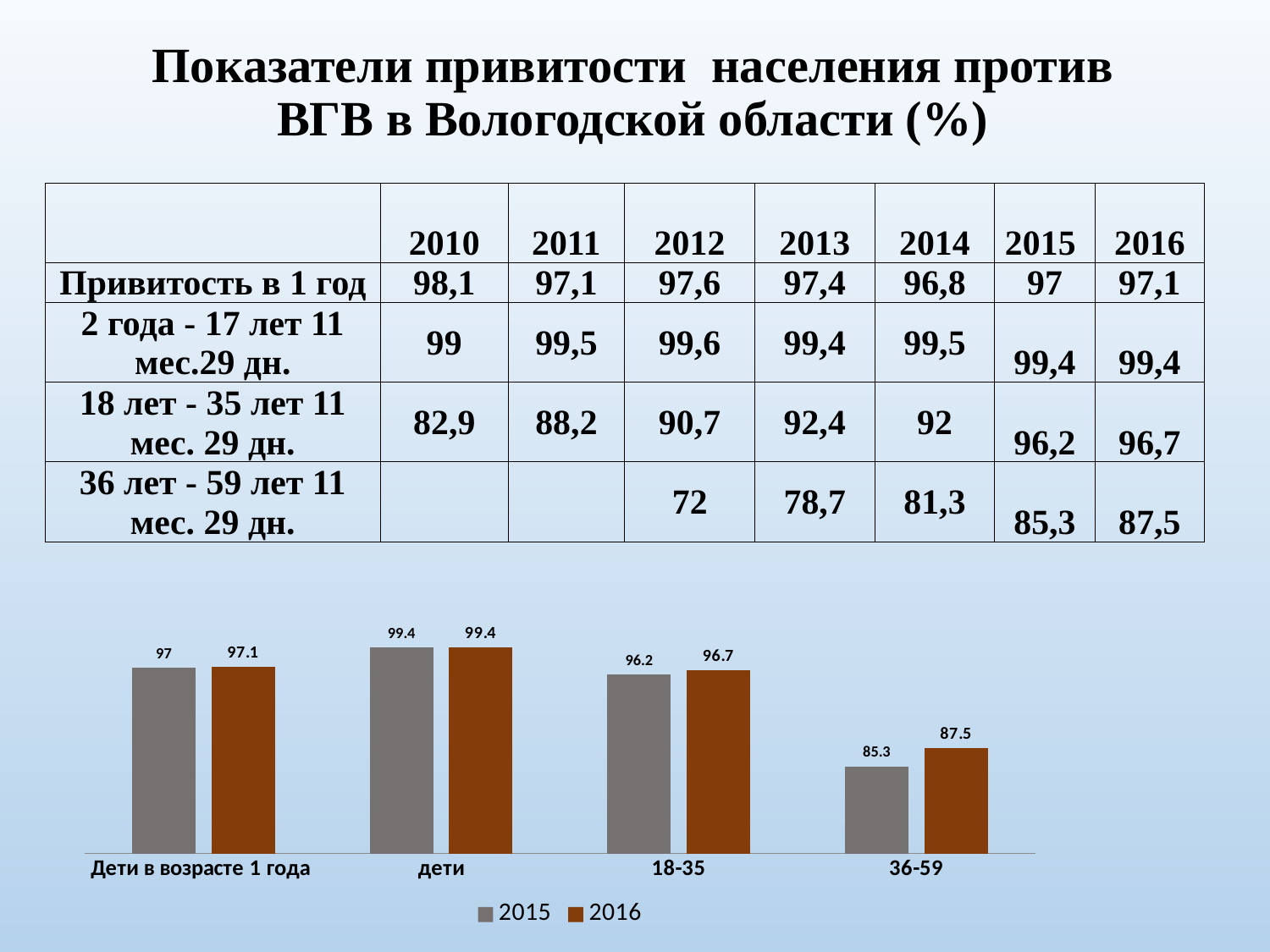
Which category has the highest value for the 2016 series on the chart? дети What kind of chart is shown on the slide? bar chart How many categories are shown on the chart? 4 What is the difference between the 2016 and 2015 values in the 18-35 category on the chart? 0.5 What is the difference between the 2016 and 2015 values in the 36-59 category on the chart? 2.2 What is the value for 2015 in the "Дети в возрасте 1 года" category on the chart? 97 What is the value for 2016 in the 36-59 category on the chart? 87.5 Which category has the lowest value for the 2015 series on the chart? 36-59 What is the value for 2015 in the 18-35 category on the chart? 96.2 Which colour represents the 2016 series on the chart? brown How many series does the chart legend list? 2 On the chart, which is larger in the 36-59 category: the 2015 value or the 2016 value? 2016